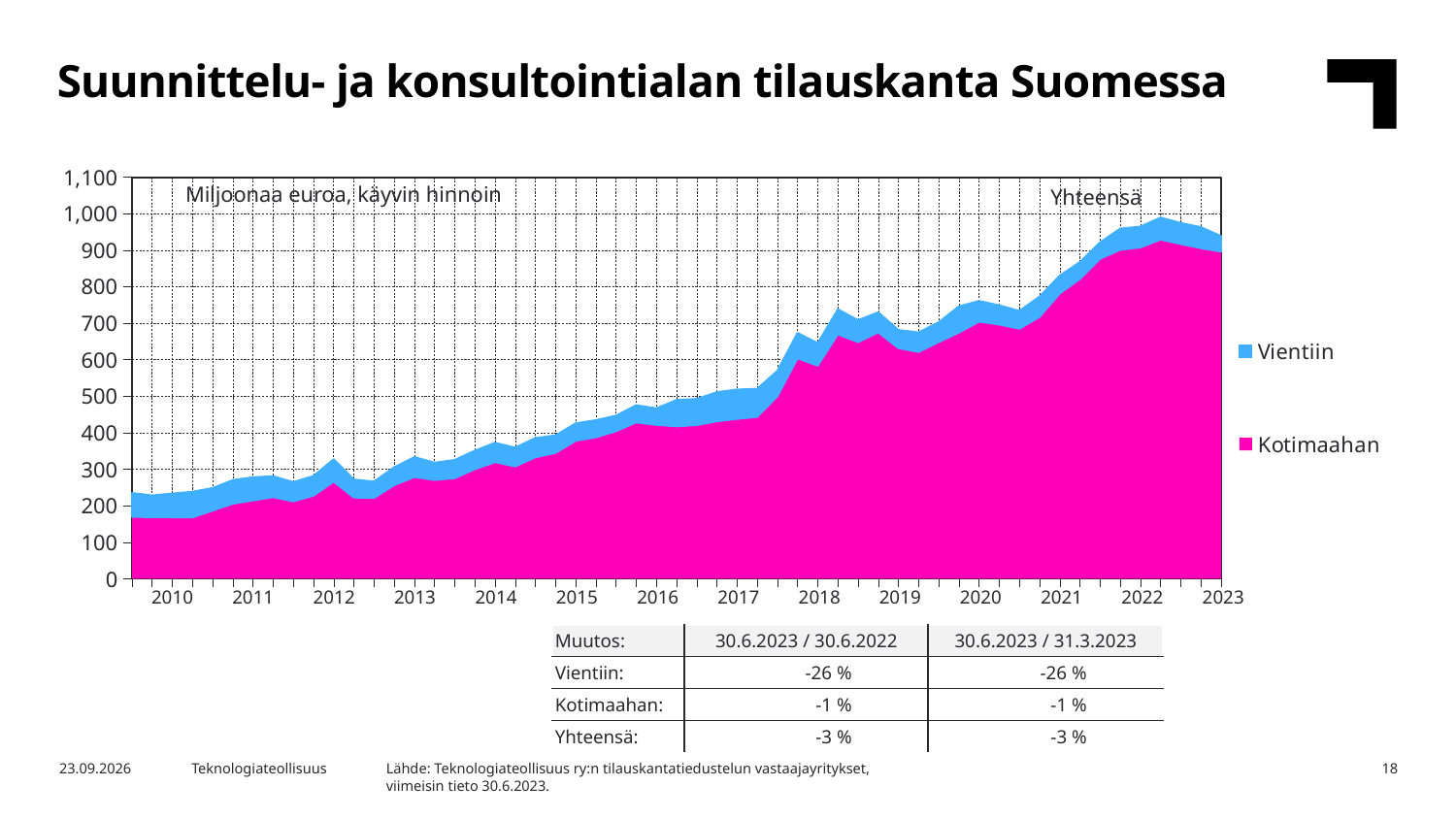
Which two series are listed in the chart legend? Vientiin and Kotimaahan What unit label is shown inside the chart area? Miljoonaa euroa, käyvin hinnoin Is the total value (Yhteensä) in 2021 greater or less than 700? greater Is the total value (Yhteensä) at the start of 2010 greater or less than 300? less Is the Kotimaahan value at the start of 2010 greater or less than 200? less What kind of chart is shown on the slide? Stacked area chart How many series does the chart legend list? 2 Does the total order backlog (Yhteensä) generally rise or fall from 2010 to 2022? Rise How many year labels are shown on the x axis? 14